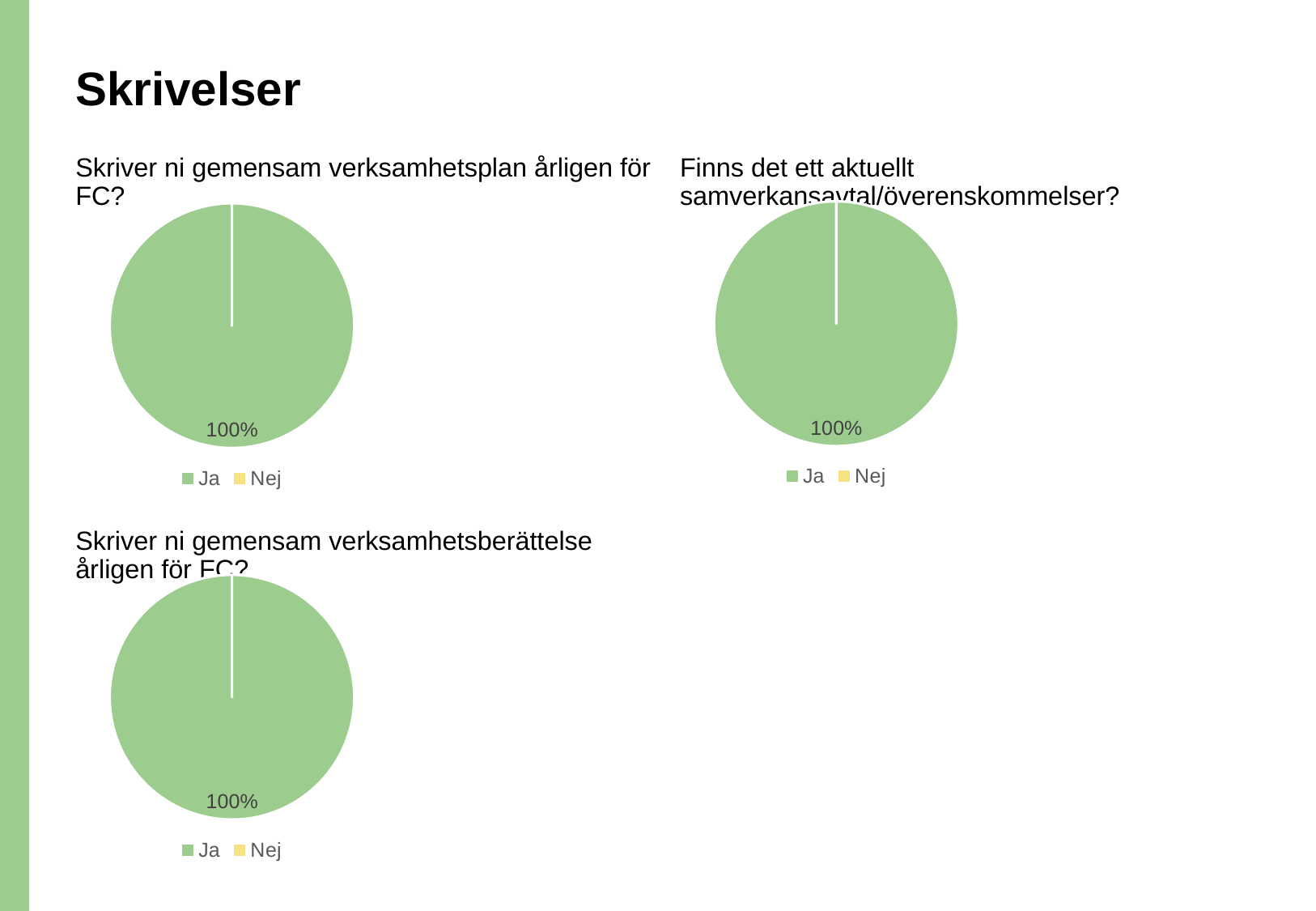
What kind of chart is the top-right chart titled "Finns det ett aktuellt samverkansavtal/överenskommelser?"? Pie chart In the bottom-left chart titled "Skriver ni gemensam verksamhetsberättelse årligen för FC?", which category has the largest share? Ja How many entries does the legend of the top-right chart titled "Finns det ett aktuellt samverkansavtal/överenskommelser?" list? 2 In the top-right chart titled "Finns det ett aktuellt samverkansavtal/överenskommelser?", what share of the pie is "Ja"? 100% In the top-left chart titled "Skriver ni gemensam verksamhetsplan årligen för FC?", which category has the largest share? Ja In the top-right chart titled "Finns det ett aktuellt samverkansavtal/överenskommelser?", which is larger, the share for "Ja" or the share for "Nej"? Ja What kind of chart is the top-left chart titled "Skriver ni gemensam verksamhetsplan årligen för FC?"? Pie chart How many entries does the legend of the bottom-left chart titled "Skriver ni gemensam verksamhetsberättelse årligen för FC?" list? 2 In the top-left chart titled "Skriver ni gemensam verksamhetsplan årligen för FC?", what share of the pie is "Ja"? 100% In the bottom-left chart titled "Skriver ni gemensam verksamhetsberättelse årligen för FC?", what share of the pie is "Ja"? 100% What are the legend entries of the top-left chart titled "Skriver ni gemensam verksamhetsplan årligen för FC?"? Ja, Nej How many pie charts are shown on the slide? 3